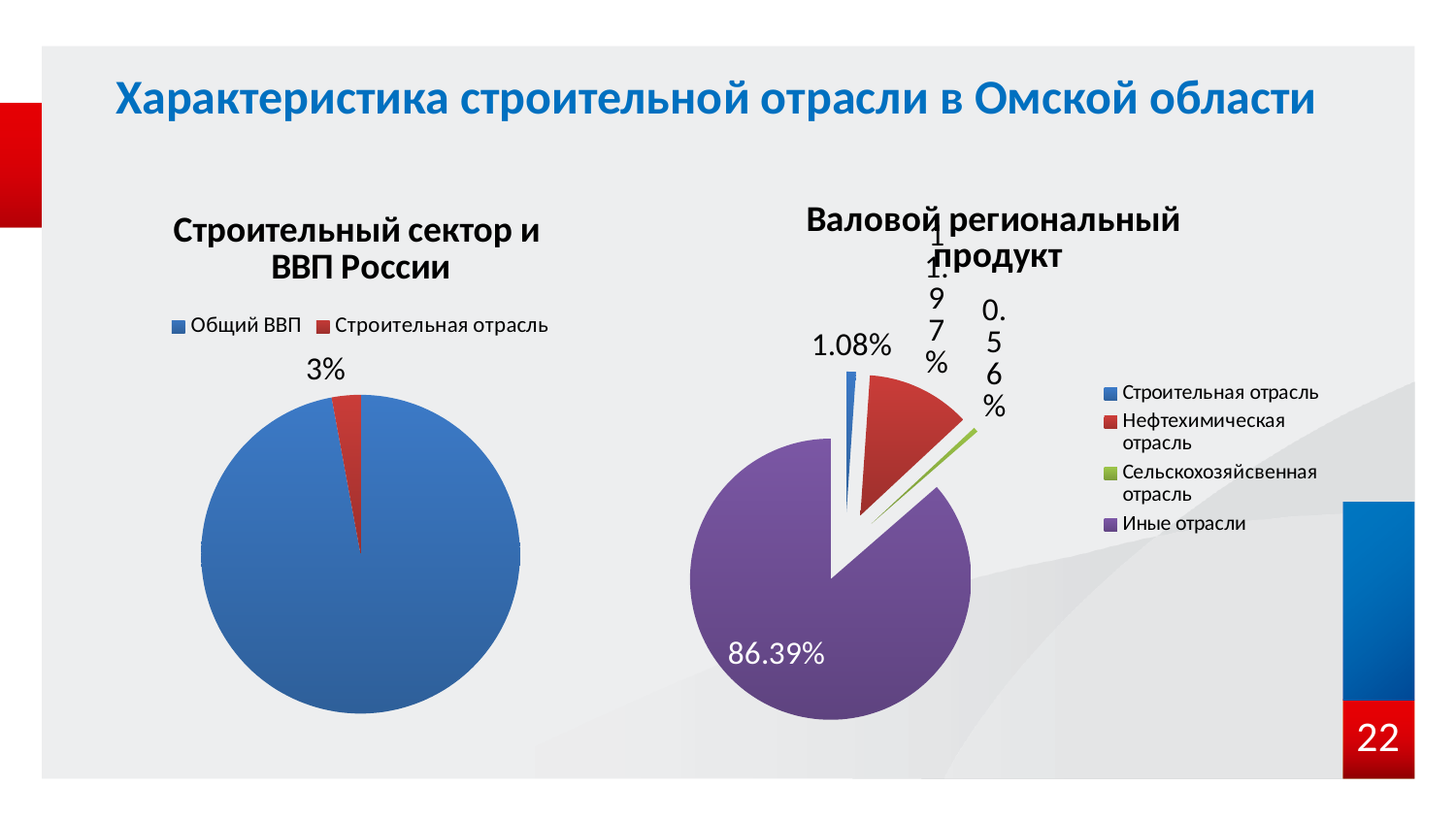
In the right chart "Валовой региональный продукт", which slice is larger: Нефтехимическая отрасль or Сельскохозяйсвенная отрасль? Нефтехимическая отрасль In the right chart "Валовой региональный продукт", what share is shown for Строительная отрасль? 1.08% In the left chart "Строительный сектор и ВВП России", what share is shown for Строительная отрасль? 3% In the right chart "Валовой региональный продукт", which category has the largest slice? Иные отрасли In the right chart "Валовой региональный продукт", what share is shown for Иные отрасли? 86.39% In the right chart "Валовой региональный продукт", what share is shown for Сельскохозяйсвенная отрасль? 0.56% In the right chart "Валовой региональный продукт", how much larger is the share of Иные отрасли than that of Строительная отрасль? 85.31% In the right chart "Валовой региональный продукт", which category has the smallest slice? Сельскохозяйсвенная отрасль In the right chart "Валовой региональный продукт", what colour is the slice for Иные отрасли? purple What kind of chart is the left chart titled "Строительный сектор и ВВП России"? pie chart How many slices does the right chart "Валовой региональный продукт" have? 4 How many entries does the legend of the left chart "Строительный сектор и ВВП России" list? 2